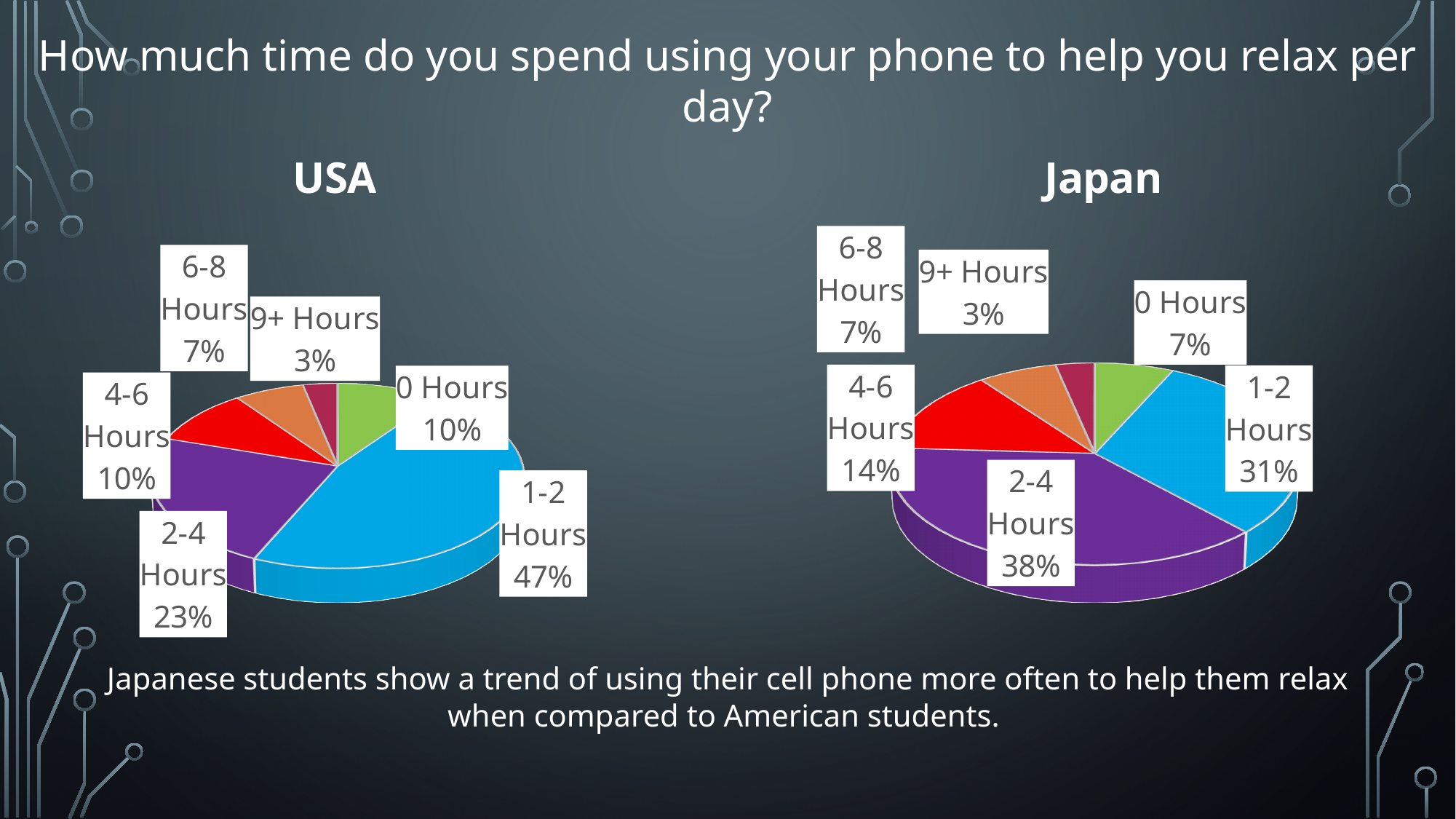
In the Japan pie chart, what is the share for 4-6 Hours? 14% What is the difference between the 1-2 Hours share in the USA chart and the 1-2 Hours share in the Japan chart? 16 percentage points In the Japan pie chart, what percentage of students spend 2-4 hours using their phone to relax per day? 38% What type of chart is used for the Japan data? Pie chart In the USA pie chart, which category has the largest share? 1-2 Hours In the Japan pie chart, which category has the largest share? 2-4 Hours Which chart shows a larger share for 2-4 Hours, USA or Japan? Japan How many categories does the USA pie chart have? 6 In the Japan pie chart, which category has the smallest share? 9+ Hours In the USA pie chart, what is the share for 0 Hours? 10% What colour is the 1-2 Hours slice in both pie charts? Blue In the USA pie chart, what percentage of students spend 1-2 hours using their phone to relax per day? 47%